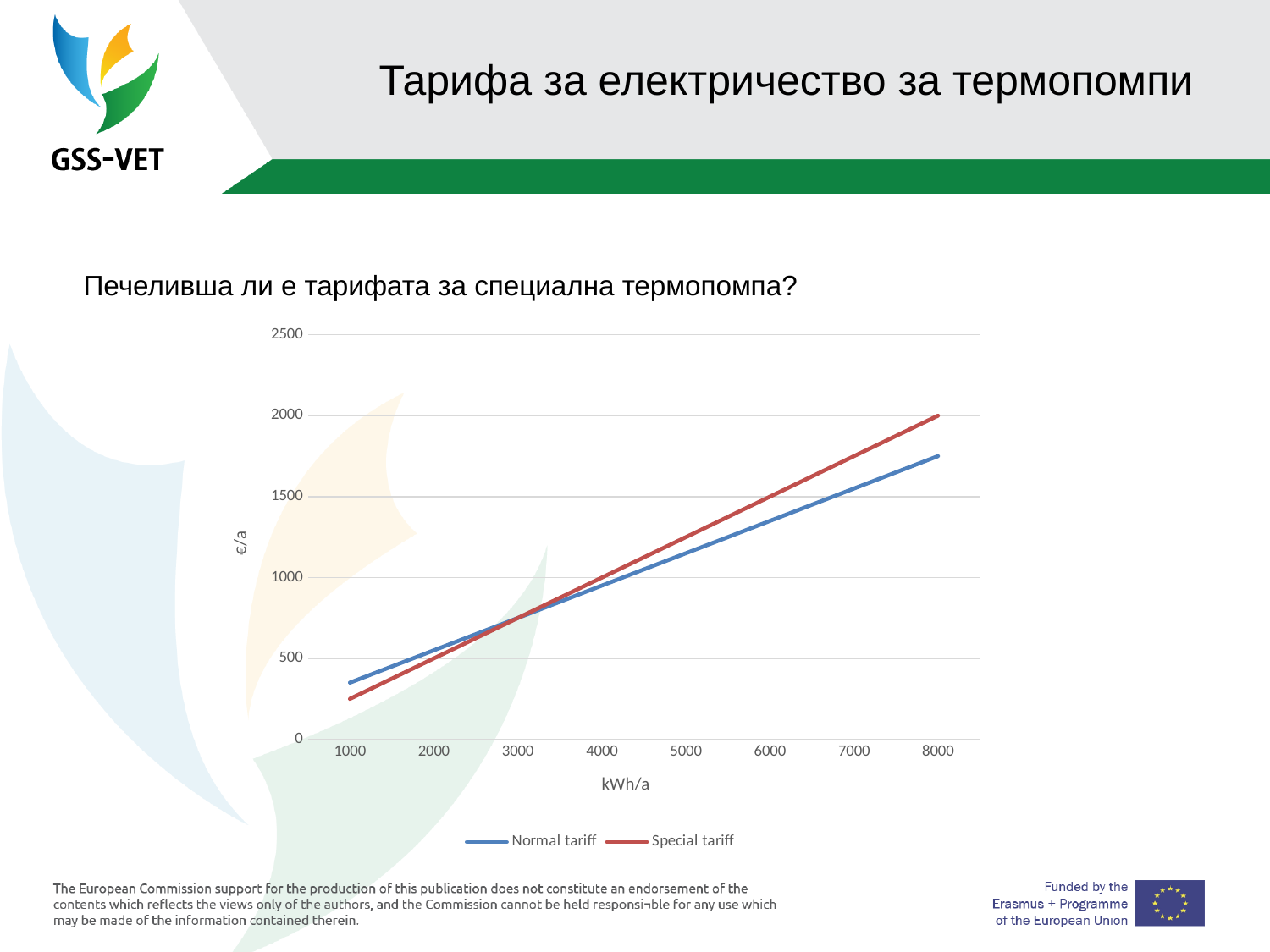
At 1000 kWh/a, which is larger: the Normal tariff or the Special tariff? Normal tariff How many series does the legend list? 2 What kind of chart is shown on the slide? line chart Is the value for the Normal tariff at 1000 kWh/a greater or less than 500? less Is the value for the Normal tariff at 8000 kWh/a greater or less than 2000? less What is the label of the y axis? €/a Do the values for the Special tariff rise or fall as kWh/a increases? rise What colour is the line for the Special tariff? red At 8000 kWh/a, which is larger: the Normal tariff or the Special tariff? Special tariff How many points are marked along the x axis (kWh/a)? 8 Is the value for the Special tariff at 8000 kWh/a greater or less than 1500? greater